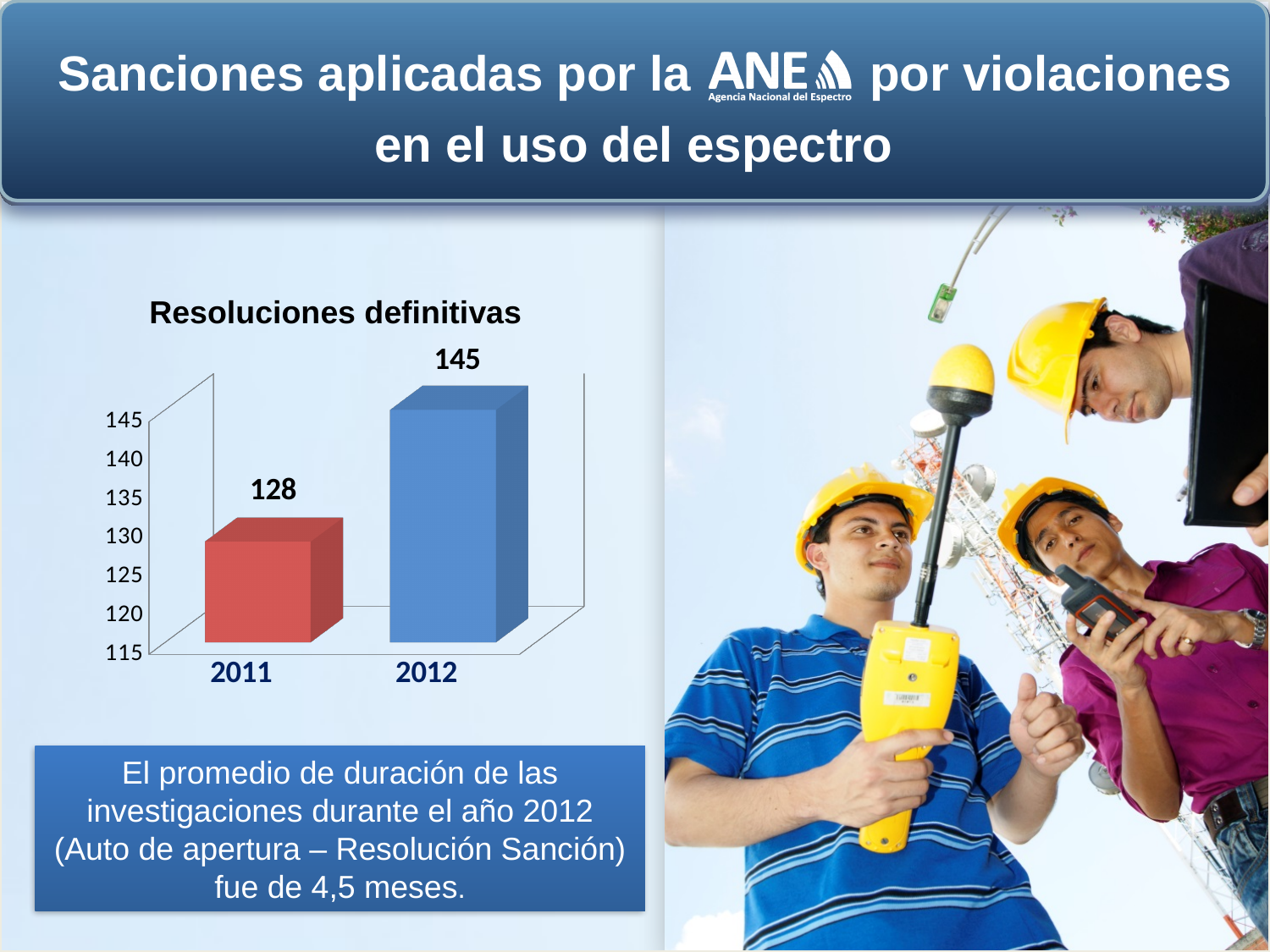
Is the value for 2011 greater or less than 130 in the Resoluciones definitivas chart? less What is the title of the chart on the slide? Resoluciones definitivas Is the value for 2012 greater or less than 140 in the Resoluciones definitivas chart? greater Do the values rise or fall from 2011 to 2012 in the Resoluciones definitivas chart? rise Which year has the lowest value in the Resoluciones definitivas chart? 2011 How many categories are shown in the Resoluciones definitivas chart? 2 Which year has the highest value in the Resoluciones definitivas chart? 2012 What is the value for 2012 in the Resoluciones definitivas chart? 145 What kind of chart is the Resoluciones definitivas chart? bar chart What is the value for 2011 in the Resoluciones definitivas chart? 128 What is the difference between the 2012 and 2011 values in the Resoluciones definitivas chart? 17 What colour is the bar for 2012 in the Resoluciones definitivas chart? blue